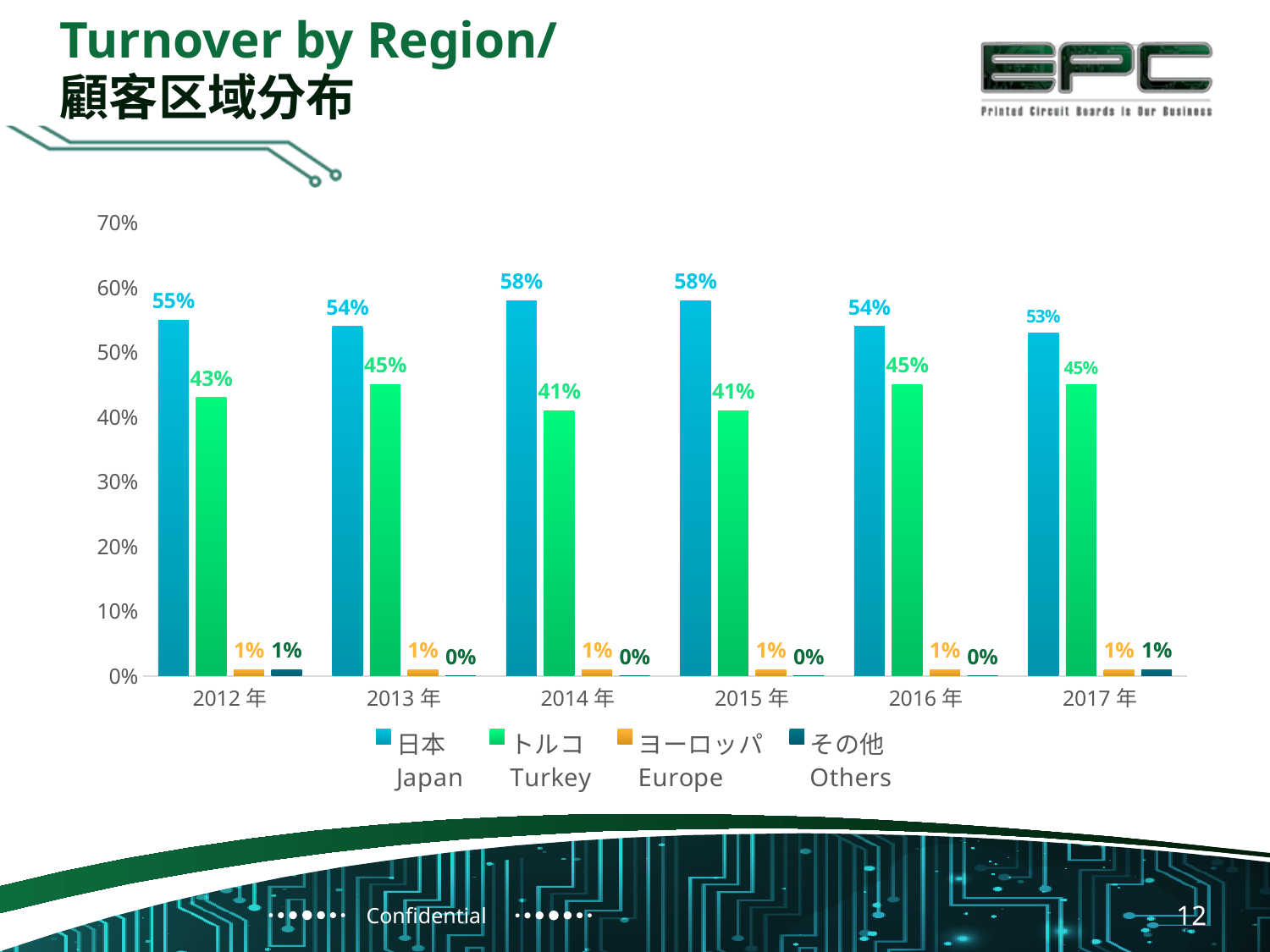
What is the value for Turkey in 2012? 43% How many series does the legend list? 4 What is the value for Europe in 2015? 1% What is the difference between the Japan and Turkey values in 2016? 9% In which year is the Turkey value lowest? 2014 and 2015 How many years are shown on the x axis? 6 In which year is the Japan value highest? 2014 and 2015 What is the title of the chart on the slide? Turnover by Region/顧客区域分布 What kind of chart is shown on the slide? Bar chart What is the value for Others in 2017? 1% Which is larger in 2013, the Japan value or the Turkey value? Japan What is the value for Japan in 2014? 58%